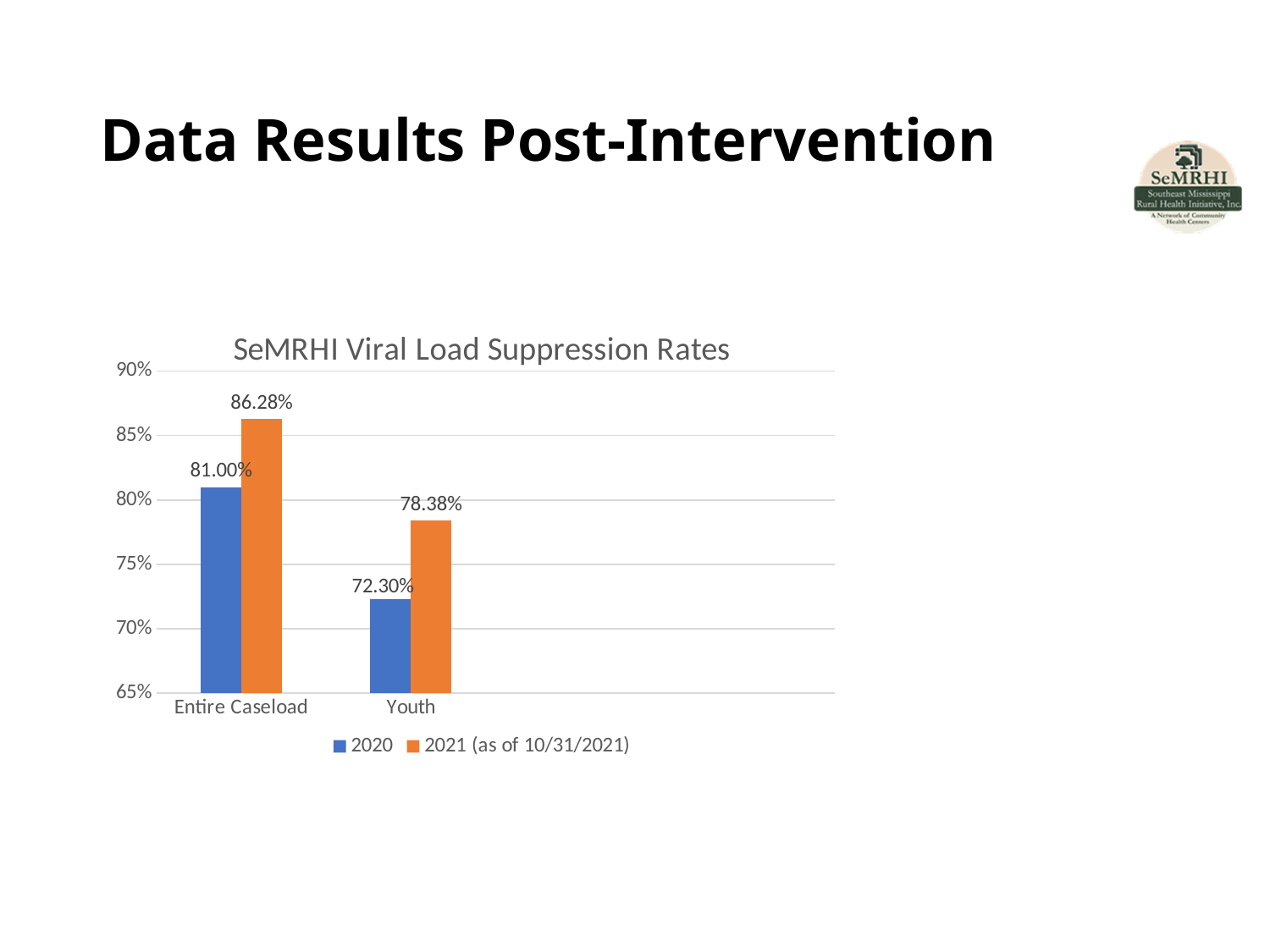
What is the 2021 (as of 10/31/2021) viral load suppression rate for Youth? 78.38% Which bar in the chart has the highest value? Entire Caseload, 2021 (as of 10/31/2021) What is the 2020 viral load suppression rate for the Entire Caseload? 81.00% What is the 2020 viral load suppression rate for Youth? 72.30% By how many percentage points did the Youth suppression rate change from 2020 to 2021? 6.08 percentage points What is the 2021 (as of 10/31/2021) viral load suppression rate for the Entire Caseload? 86.28% Which is larger: the 2020 rate for the Entire Caseload or the 2021 rate for Youth? 2020 rate for the Entire Caseload Which bar in the chart has the lowest value? Youth, 2020 How many series does the legend list? 2 How many categories are shown on the x axis of the chart? 2 What is the title of the chart? SeMRHI Viral Load Suppression Rates By how many percentage points did the Entire Caseload suppression rate change from 2020 to 2021? 5.28 percentage points